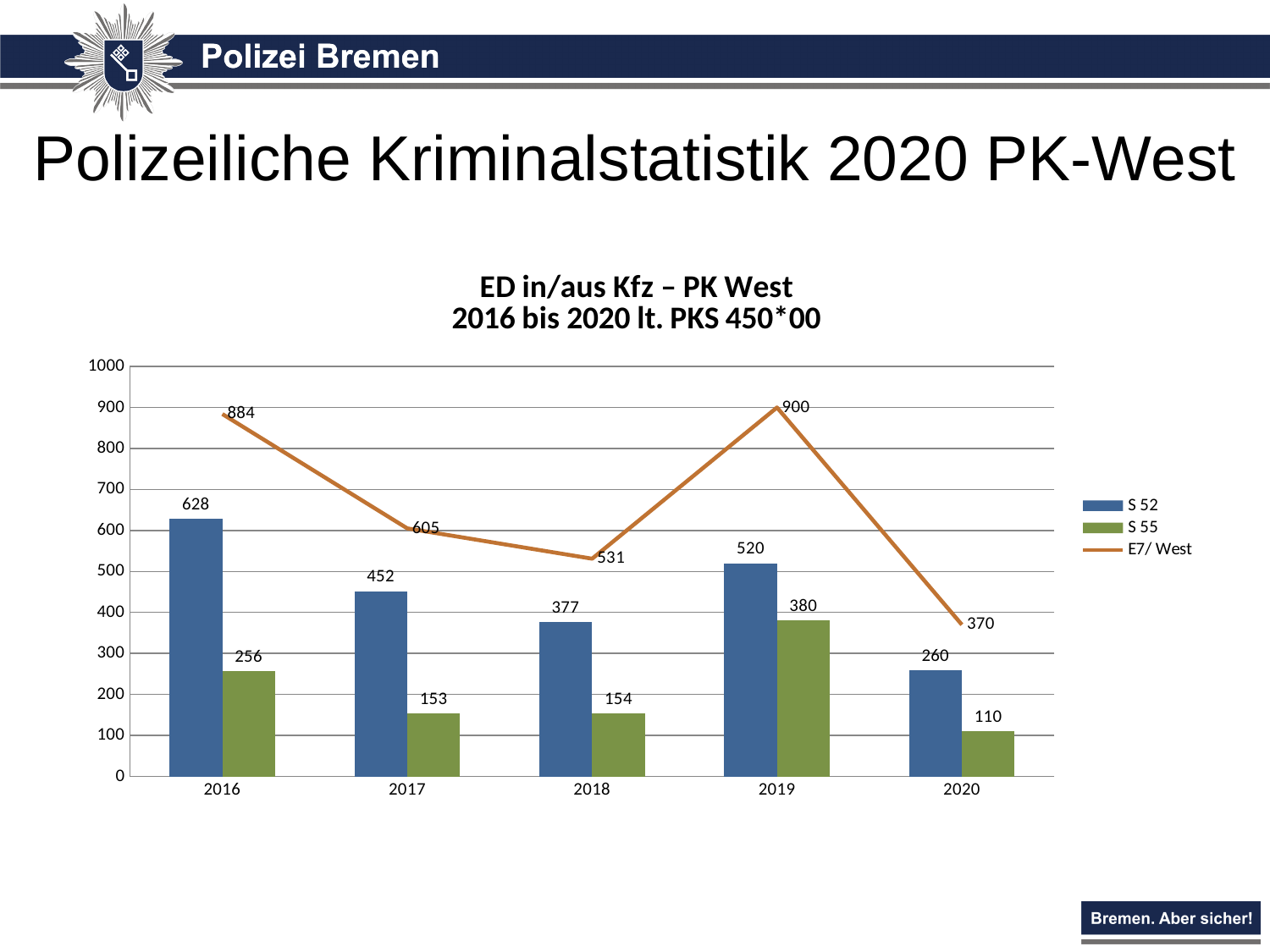
What is the title of the chart? ED in/aus Kfz – PK West 2016 bis 2020 lt. PKS 450*00 What is the value of S 52 in 2016? 628 Which is larger in 2020: S 52 or E7/ West? E7/ West What is the value of E7/ West in 2018? 531 In which year is the E7/ West line highest? 2019 In which year is S 55 lowest? 2020 What is the difference between S 52 and S 55 in 2017? 299 How many series does the legend list? 3 Does the S 52 series rise or fall from 2016 to 2018? fall What kind of chart is used for the S 52 and S 55 series? bar chart How many years are shown on the x axis? 5 What is the value of S 55 in 2019? 380